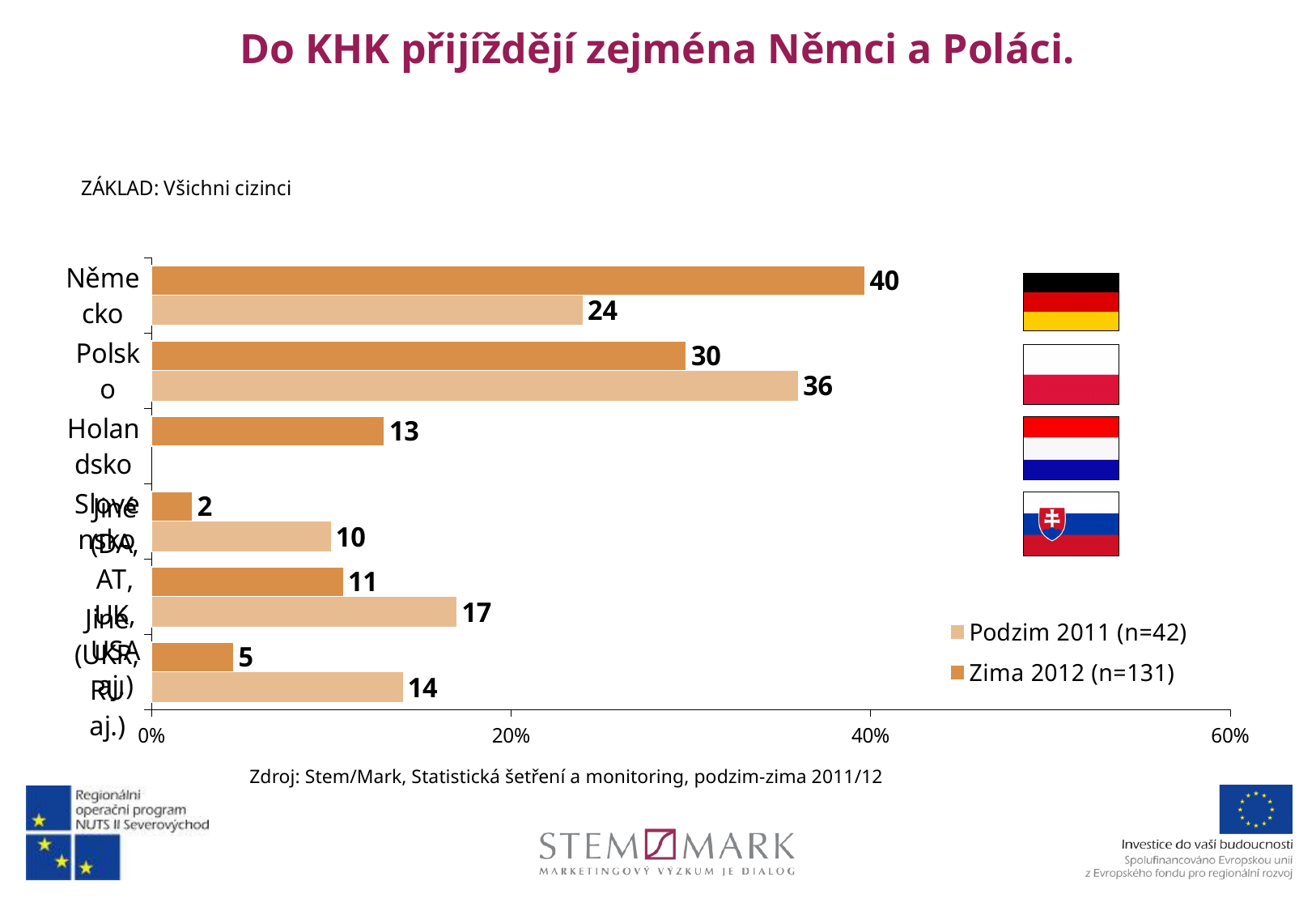
What is the value for Německo in the Podzim 2011 (n=42) series? 24 What is the value for Polsko in the Podzim 2011 (n=42) series? 36 Which category has the highest value in the Zima 2012 (n=131) series? Německo What kind of chart is shown on the slide? Bar chart What is the value for Německo in the Zima 2012 (n=131) series? 40 Which is larger for Polsko: the Podzim 2011 value or the Zima 2012 value? Podzim 2011 What is the difference between the Zima 2012 and Podzim 2011 values for Německo? 16 What is the value for Holandsko in the Zima 2012 (n=131) series? 13 What is the title of the slide? Do KHK přijíždějí zejména Němci a Poláci. Which category has the highest value in the Podzim 2011 (n=42) series? Polsko How many series does the legend list? 2 What is the value for Polsko in the Zima 2012 (n=131) series? 30